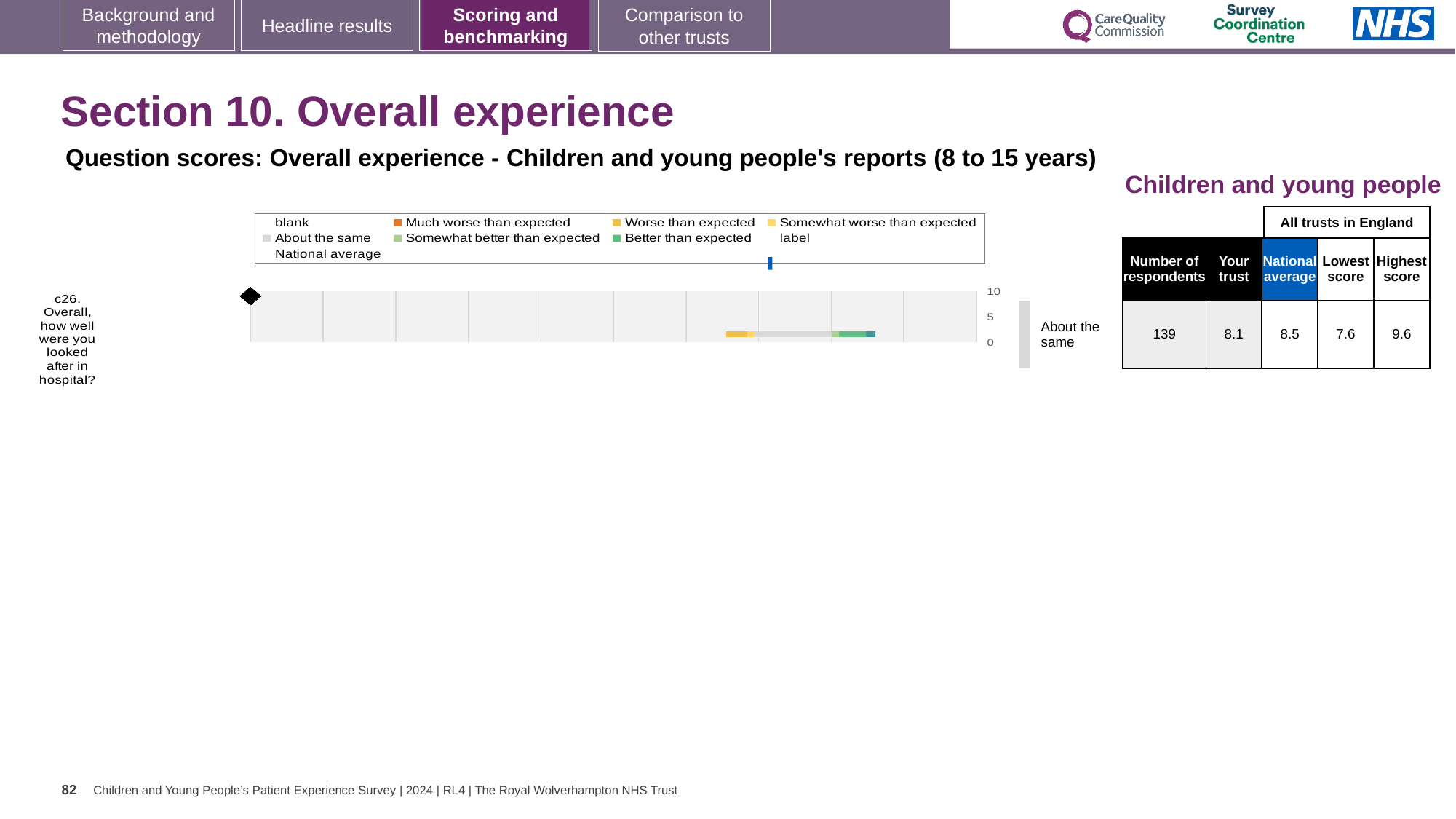
Which is higher for question c26: the 'Your trust' score or the national average? National average What is the difference between the highest score and the lowest score for question c26? 2.0 What is the national average score for question c26? 8.5 What is the lowest score among all trusts in England for question c26? 7.6 What is the maximum value shown on the chart's score axis? 10 By how much does the national average exceed the 'Your trust' score for question c26? 0.4 What kind of chart is used to show the question score for c26? bar chart What is the highest score among all trusts in England for question c26? 9.6 What is the 'Your trust' score for question c26, 'Overall, how well were you looked after in hospital?' 8.1 How many respondents answered question c26? 139 How many questions (categories) are plotted on the chart? 1 What benchmark category is shown next to the chart for question c26? About the same